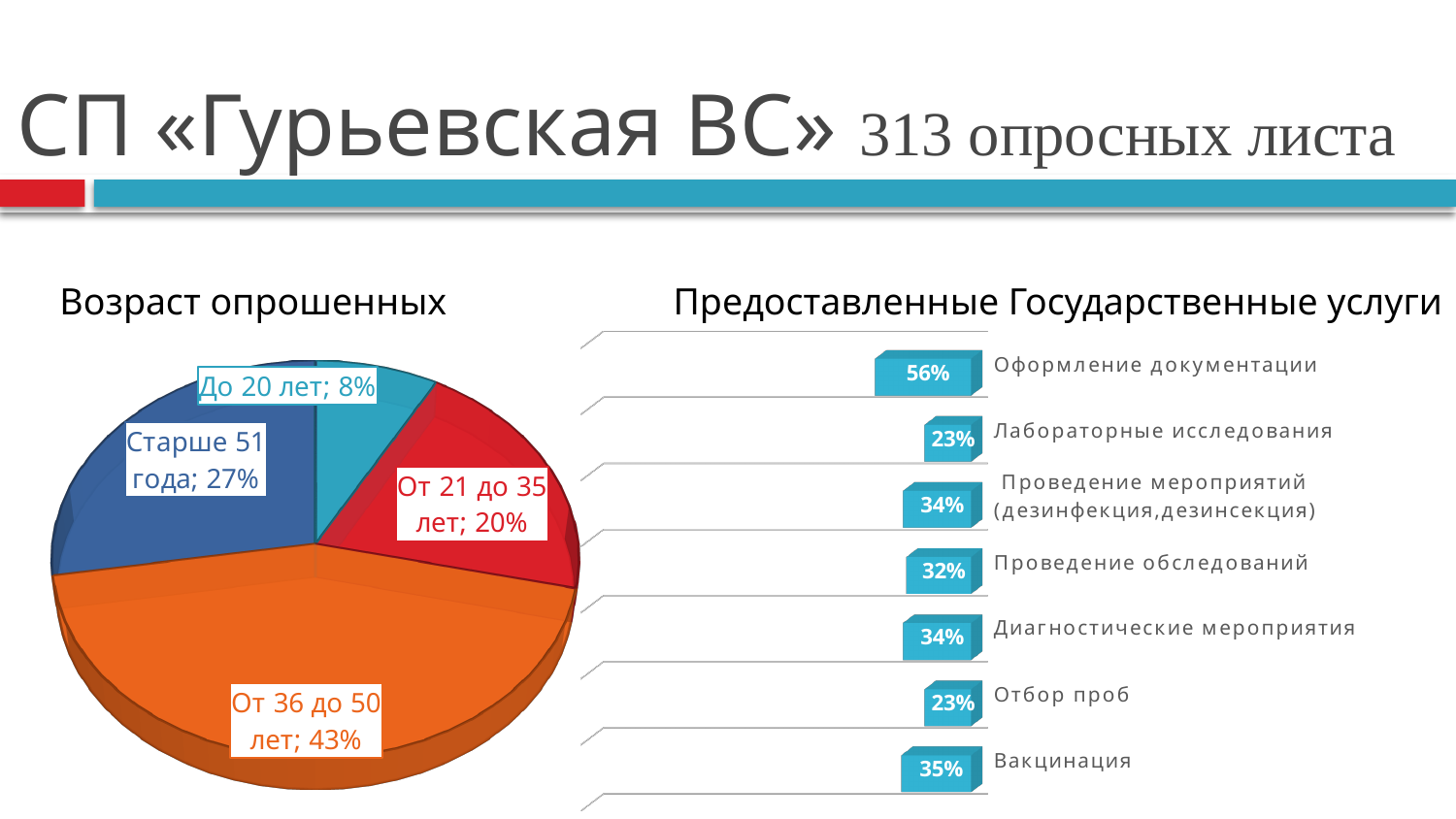
In the chart titled «Возраст опрошенных», which age group has the smallest share? До 20 лет In the chart titled «Предоставленные Государственные услуги», what is the value for «Вакцинация»? 35% In the chart titled «Предоставленные Государственные услуги», which service has the highest value? Оформление документации In the chart titled «Предоставленные Государственные услуги», what is the value for «Оформление документации»? 56% In the chart titled «Возраст опрошенных», how many age groups are shown? 4 In the chart titled «Предоставленные Государственные услуги», how many services are listed? 7 What kind of chart is the one titled «Возраст опрошенных»? Pie chart In the chart titled «Возраст опрошенных», what is the difference in percentage points between «Старше 51 года» and «От 21 до 35 лет»? 7 In the chart titled «Возраст опрошенных», which age group has the largest share? От 36 до 50 лет In the chart titled «Предоставленные Государственные услуги», which is larger: «Проведение обследований» or «Вакцинация»? Вакцинация In the chart titled «Возраст опрошенных», what share of respondents are «От 36 до 50 лет»? 43% In the chart titled «Возраст опрошенных», what share of respondents are «До 20 лет»? 8%